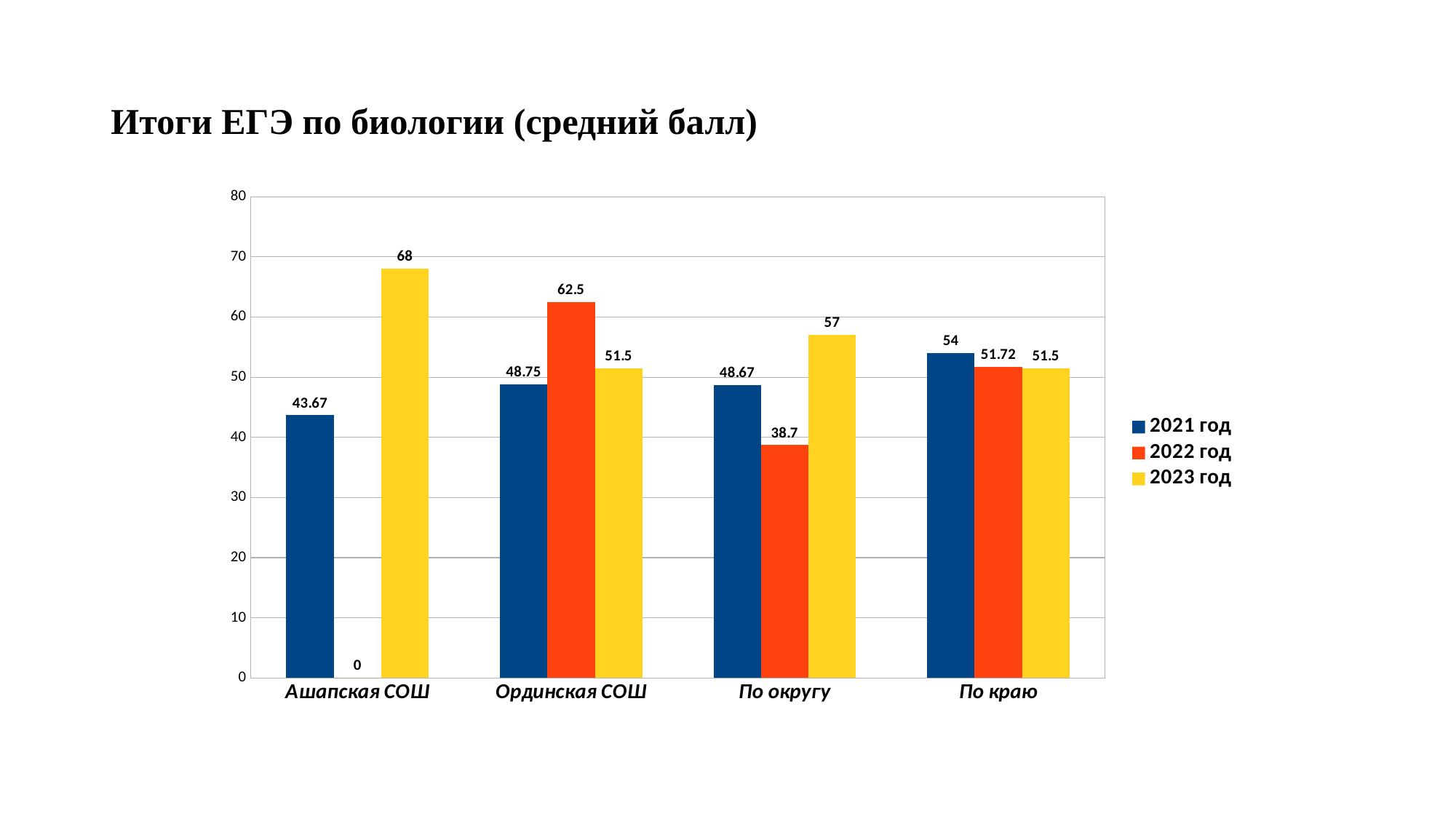
What is the value for По краю in the 2022 год series? 51.72 What is the title of the slide? Итоги ЕГЭ по биологии (средний балл) How many series does the legend list? 3 What is the value for Ашапская СОШ in the 2023 год series? 68 What kind of chart is shown on the slide? bar chart What is the value for Ординская СОШ in the 2022 год series? 62.5 Which is larger for По округу: the 2021 год value or the 2022 год value? 2021 год What is the difference between the 2023 год and 2021 год values for Ашапская СОШ? 24.33 Which category has the lowest value in the 2022 год series? Ашапская СОШ Which category has the highest value in the 2023 год series? Ашапская СОШ How many categories are shown on the x axis? 4 What is the value for По округу in the 2021 год series? 48.67